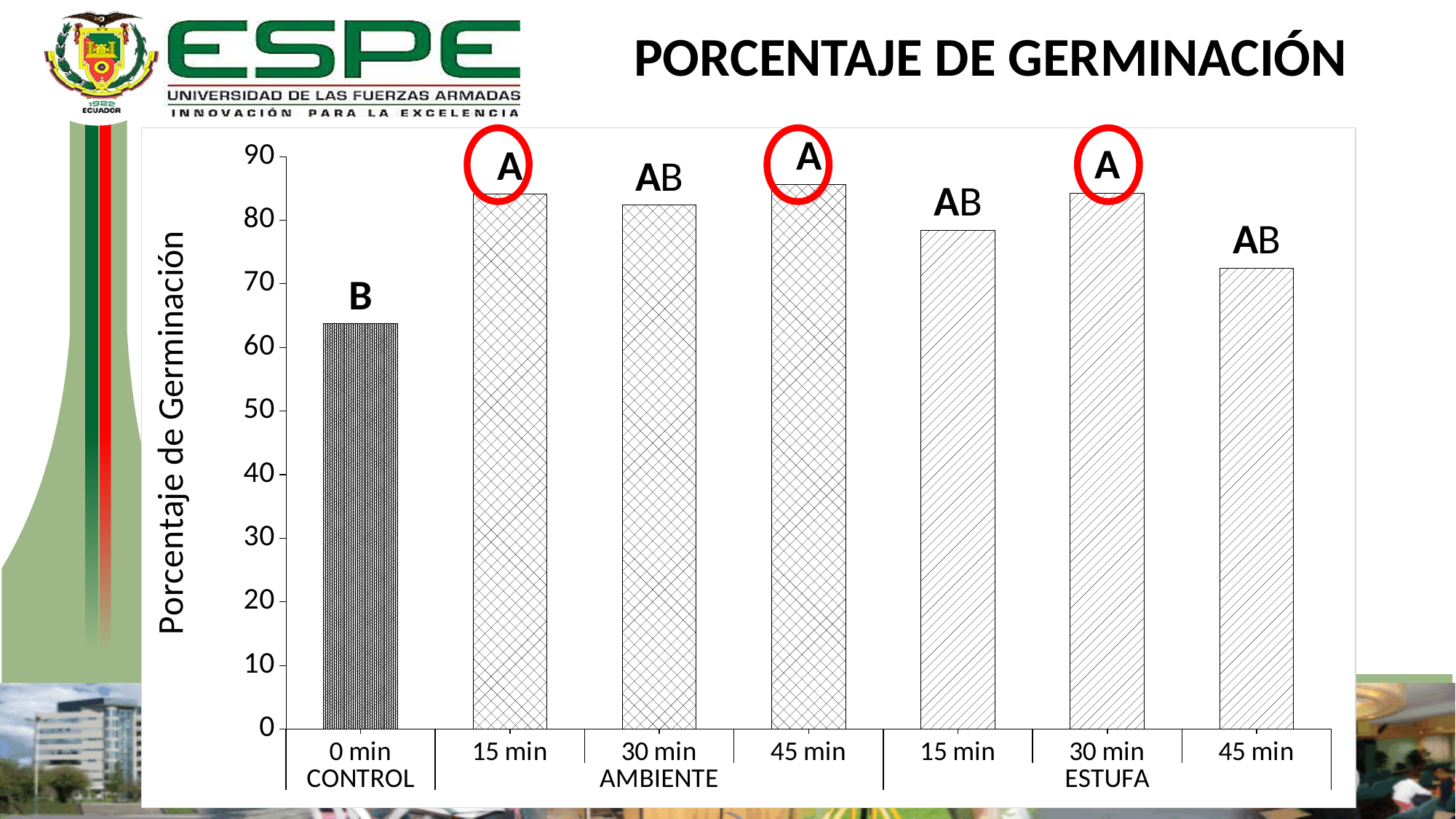
What kind of chart is shown on the slide? bar chart Is the value for 0 min CONTROL greater or less than 60? greater Is the value for 0 min CONTROL greater or less than 70? less Is the value for 15 min ESTUFA greater or less than 70? greater Which bar has the lowest germination percentage? 0 min CONTROL Which is larger, the value for 0 min CONTROL or the value for 15 min AMBIENTE? 15 min AMBIENTE What letter label is shown above the 0 min CONTROL bar? B How many bars are plotted in the chart? 7 What is the title of the chart? PORCENTAJE DE GERMINACIÓN Which is larger, the value for 15 min ESTUFA or the value for 45 min ESTUFA? 15 min ESTUFA